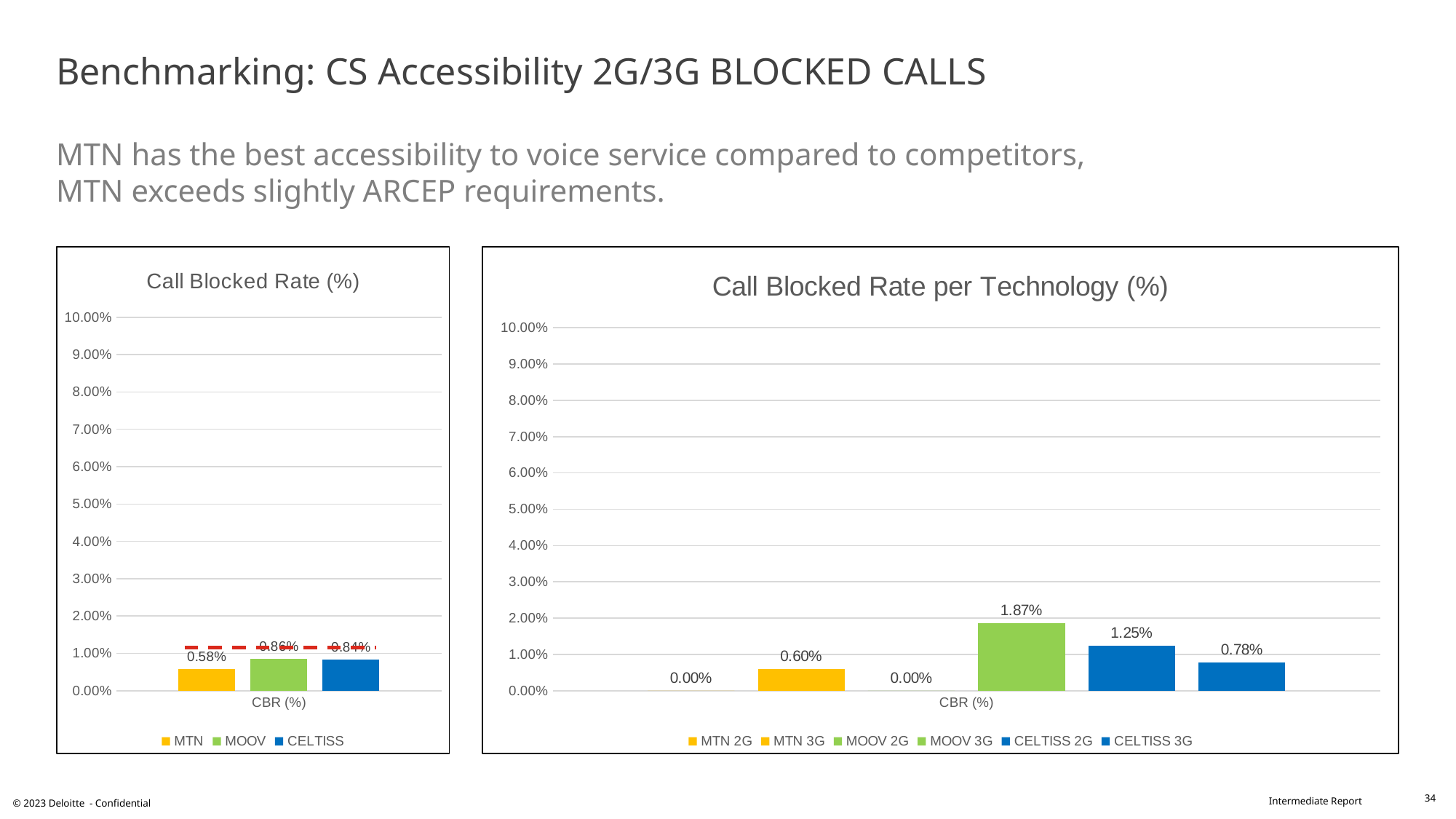
In the 'Call Blocked Rate per Technology (%)' chart, what is the value for CELTISS 2G? 1.25% In the 'Call Blocked Rate per Technology (%)' chart, which series has the highest call blocked rate? MOOV 3G In the 'Call Blocked Rate (%)' chart on the left, what is the value for MTN? 0.58% In the 'Call Blocked Rate per Technology (%)' chart, what is the difference between MOOV 3G and CELTISS 2G? 0.62% In the 'Call Blocked Rate (%)' chart on the left, how many series does the legend list? 3 What kind of chart is the 'Call Blocked Rate (%)' chart on the left? Bar chart In the 'Call Blocked Rate per Technology (%)' chart, what is the value for MTN 3G? 0.60% In the 'Call Blocked Rate per Technology (%)' chart, what is the value for MOOV 3G? 1.87% In the 'Call Blocked Rate per Technology (%)' chart, how many series does the legend list? 6 In the 'Call Blocked Rate (%)' chart on the left, which operator has the lowest call blocked rate? MTN In the 'Call Blocked Rate per Technology (%)' chart, which is larger, CELTISS 2G or CELTISS 3G? CELTISS 2G In the 'Call Blocked Rate per Technology (%)' chart, what is the value for MTN 2G? 0.00%